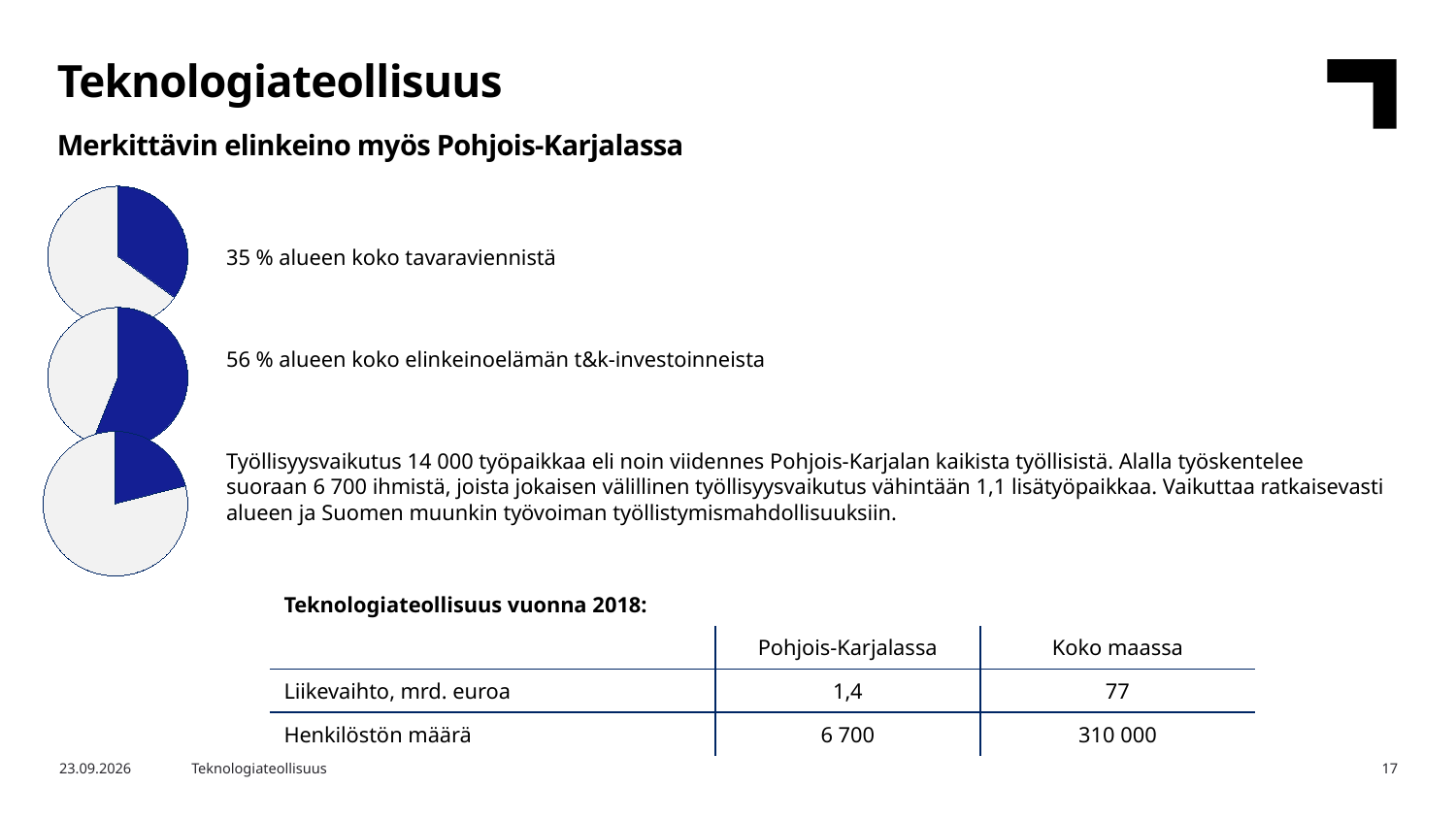
Is the blue slice larger in the top pie chart or in the middle pie chart? Middle Which pie chart has the smallest blue slice: the top, middle or bottom one? Bottom How many slices does each pie chart have? 2 What kind of charts are the three charts on the left side of the slide? Pie charts Does the blue slice in the middle pie chart represent more or less than half of the pie? More Does the blue slice in the bottom pie chart represent more or less than half of the pie? Less In the middle pie chart, what share does the blue slice represent? 56 % How many pie charts are shown on the slide? 3 Which pie chart has the largest blue slice: the top, middle or bottom one? Middle What does the top pie chart illustrate, according to the text next to it? 35 % alueen koko tavaraviennistä Is the blue slice larger in the top pie chart or in the bottom pie chart? Top In the top pie chart, what share does the blue slice represent? 35 %